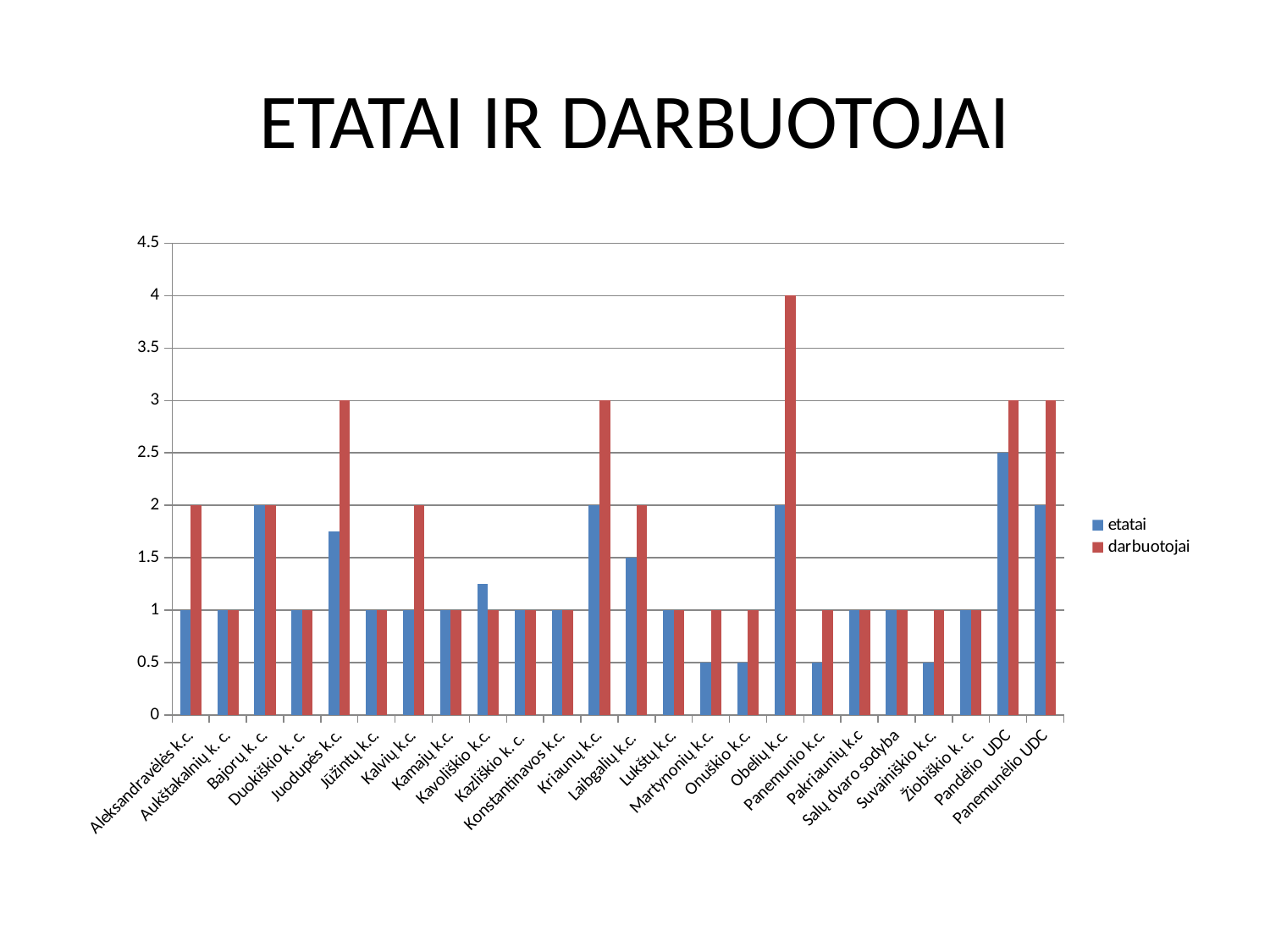
How many series does the legend list? 2 What is the difference between the darbuotojai and etatai values for Aleksandravėlės k.c.? 1 What is the darbuotojai value for Obelių k.c.? 4 How many categories are shown on the x axis? 24 What is the etatai value for Pandėlio UDC? 2.5 What type of chart is shown on the slide? bar chart Which is larger for Laibgalių k.c., etatai or darbuotojai? darbuotojai What is the darbuotojai value for Kriaunų k.c.? 3 Is the etatai value for Juodupės k.c. greater or less than 1.5? greater Which category has the highest darbuotojai value? Obelių k.c. What is the title of the chart on the slide? ETATAI IR DARBUOTOJAI Which category has the highest etatai value? Pandėlio UDC